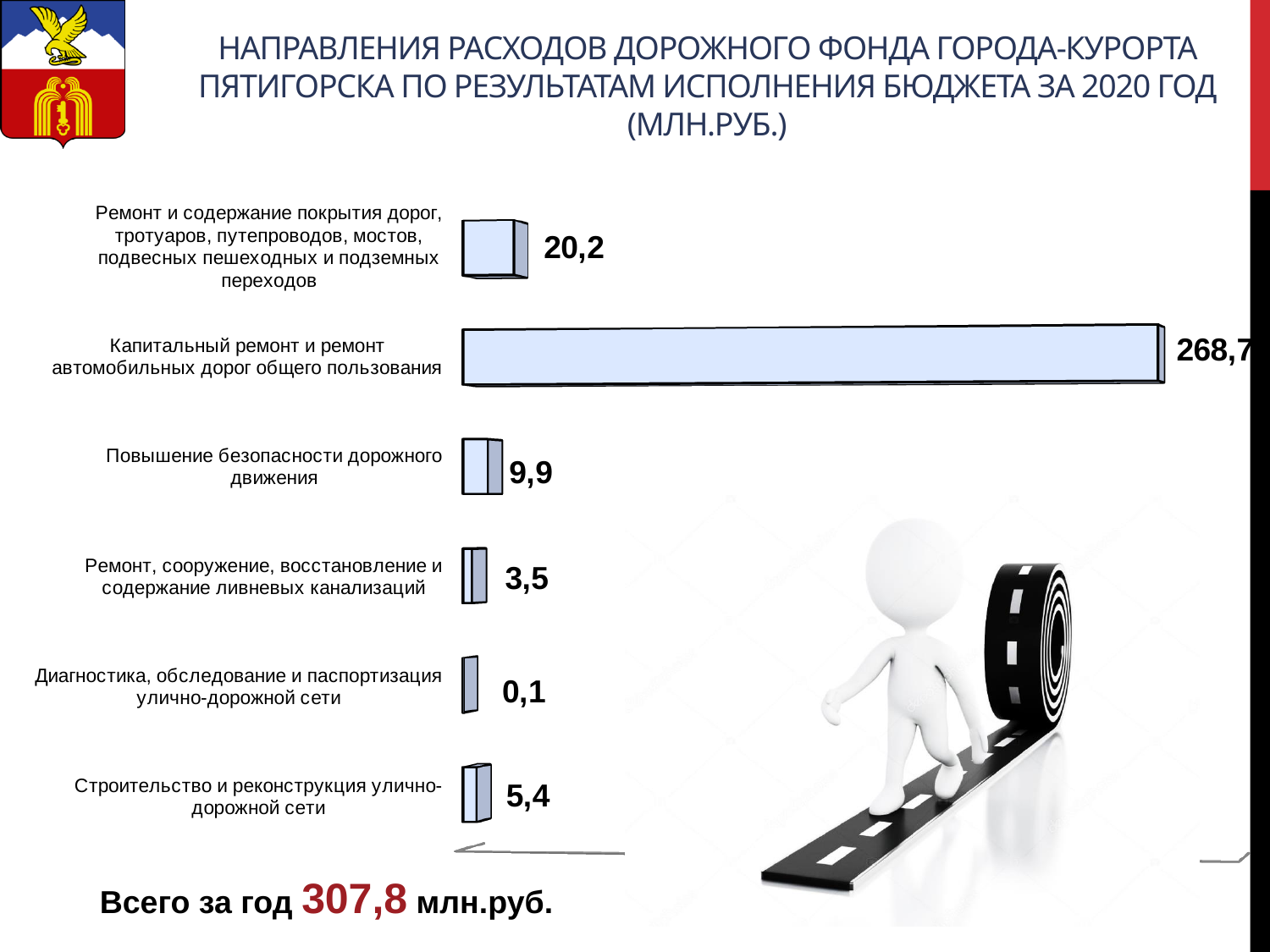
На сколько значение категории «Капитальный ремонт и ремонт автомобильных дорог общего пользования» больше значения категории «Ремонт и содержание покрытия дорог, тротуаров, путепроводов, мостов, подвесных пешеходных и подземных переходов»? 248,5 Какое значение указано для категории «Капитальный ремонт и ремонт автомобильных дорог общего пользования»? 268,7 Какая из двух категорий имеет большее значение: «Повышение безопасности дорожного движения» или «Строительство и реконструкция улично-дорожной сети»? Повышение безопасности дорожного движения Сколько категорий показано на диаграмме? 6 Какое значение указано для категории «Диагностика, обследование и паспортизация улично-дорожной сети»? 0,1 В каких единицах измерения приведены значения на диаграмме согласно заголовку? млн.руб. Какое значение указано для категории «Строительство и реконструкция улично-дорожной сети»? 5,4 Какая категория имеет наименьшее значение на диаграмме? Диагностика, обследование и паспортизация улично-дорожной сети Какова общая сумма расходов за год, указанная на слайде? 307,8 млн.руб. Какой тип диаграммы показан на слайде? Столбчатая (bar chart) Какое значение указано для категории «Повышение безопасности дорожного движения»? 9,9 Какая категория имеет наибольшее значение на диаграмме? Капитальный ремонт и ремонт автомобильных дорог общего пользования